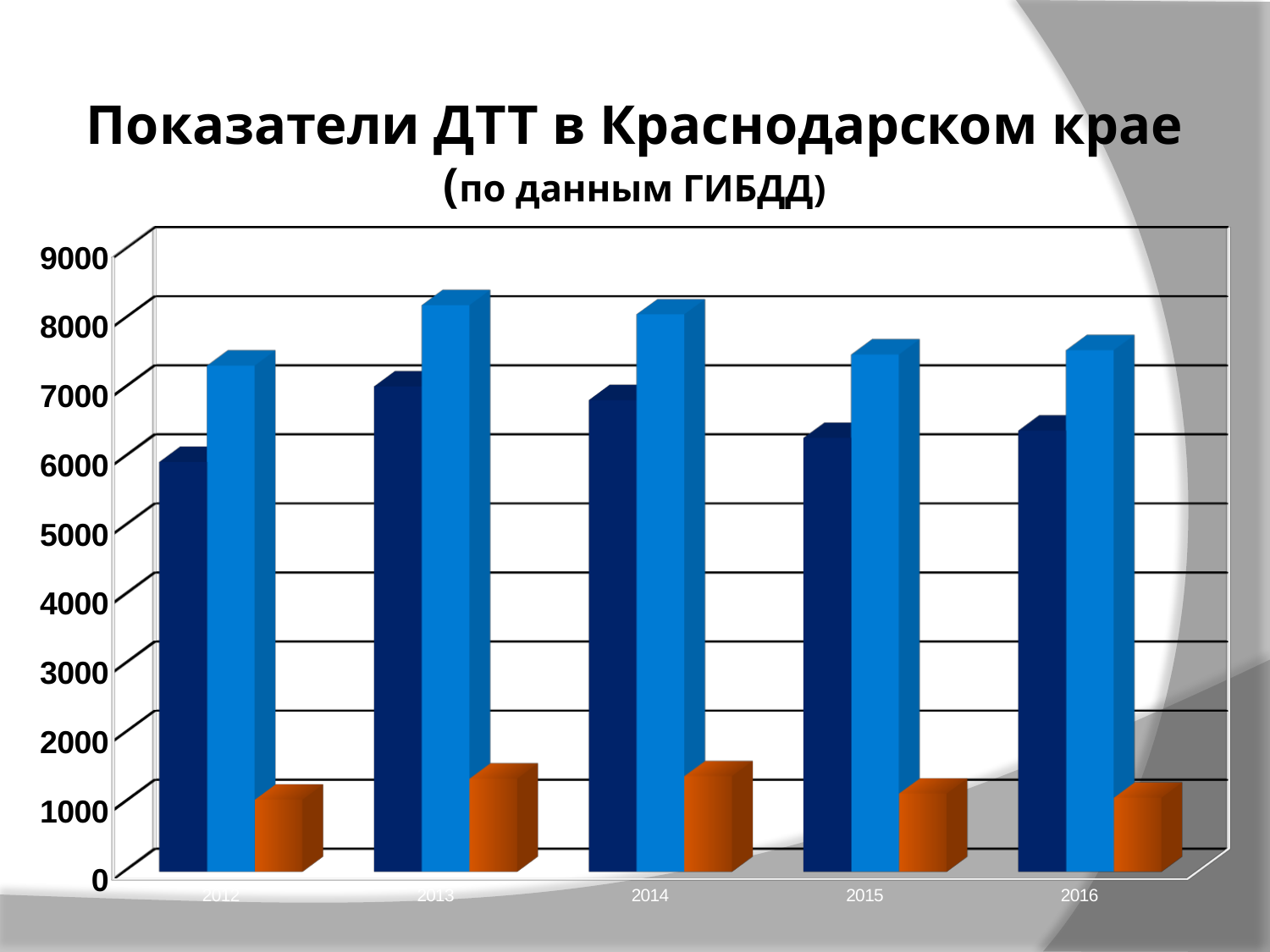
How many years are shown on the x axis of the chart? 5 Is the value of the dark blue bar for 2012 greater or less than 5000? greater Which is larger: the light blue bar for 2013 or the light blue bar for 2016? 2013 In which year is the light blue bar the highest? 2013 Is the value of the orange bar for 2014 greater or less than 2000? less Which is larger in 2015: the dark blue bar or the light blue bar? the light blue bar Is the value of the light blue bar for 2013 greater or less than 7000? greater Do the dark blue bars rise or fall from 2013 to 2015? fall In which year is the dark blue bar the lowest? 2012 What is the title of the chart on the slide? Показатели ДТТ в Краснодарском крае (по данным ГИБДД) What kind of chart is shown on the slide? bar chart How many bars are plotted for each year in the chart? 3